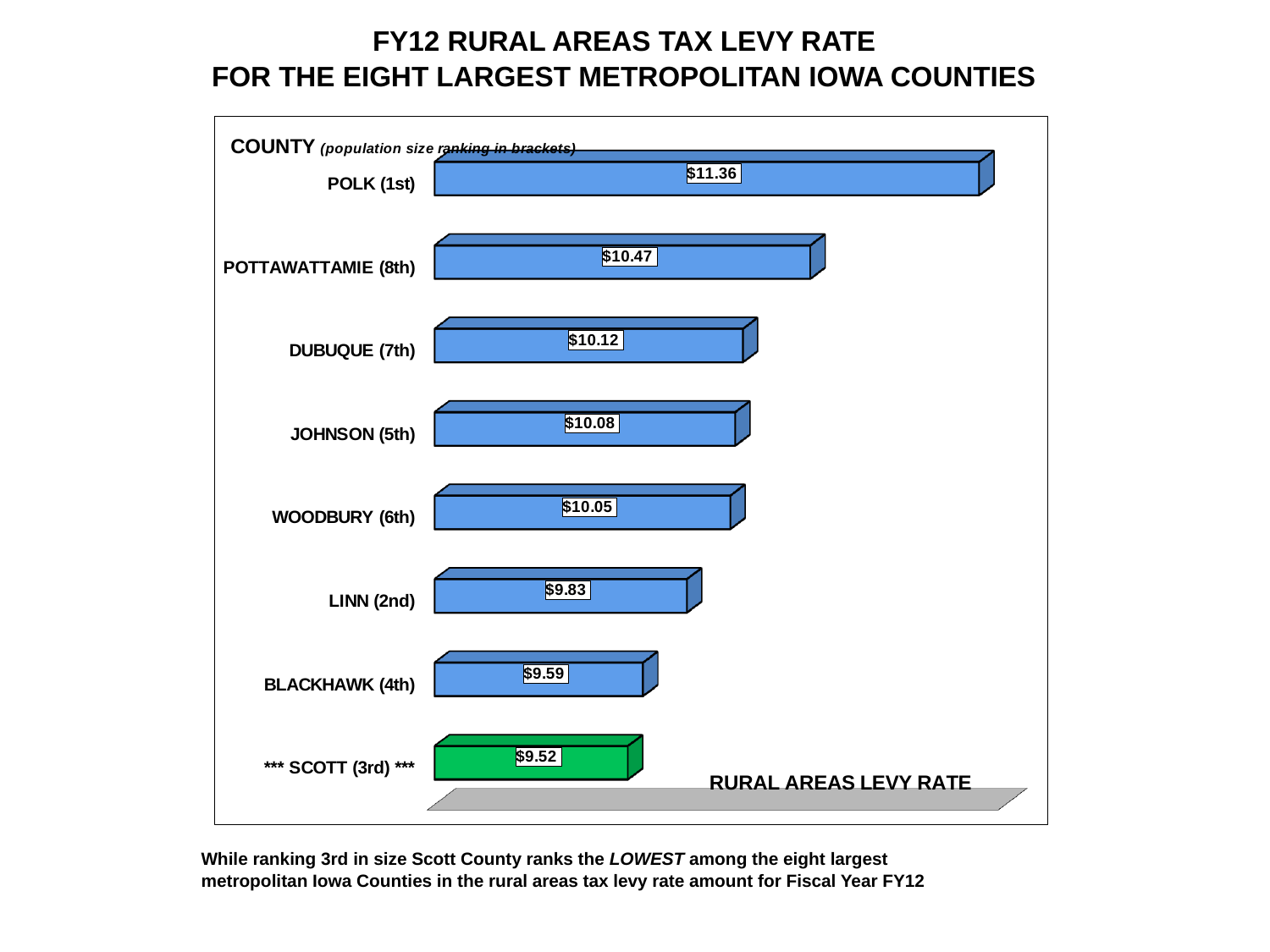
What is the population size ranking shown in brackets for Woodbury County? 6th What is the rural areas tax levy rate for Dubuque County? $10.12 Which county's bar is coloured green instead of blue? Scott What is the rural areas tax levy rate for Polk County? $11.36 Which county has the highest rural areas tax levy rate? Polk What kind of chart is shown on the slide? Bar chart What is the difference between the levy rates of Polk County and Scott County? $1.84 What is the rural areas tax levy rate for Scott County? $9.52 What is the difference between the levy rates of Pottawattamie County and Linn County? $0.64 Which county has a higher rural areas tax levy rate, Linn or Blackhawk? Linn How many counties are shown in the chart? 8 Which county has the lowest rural areas tax levy rate? Scott